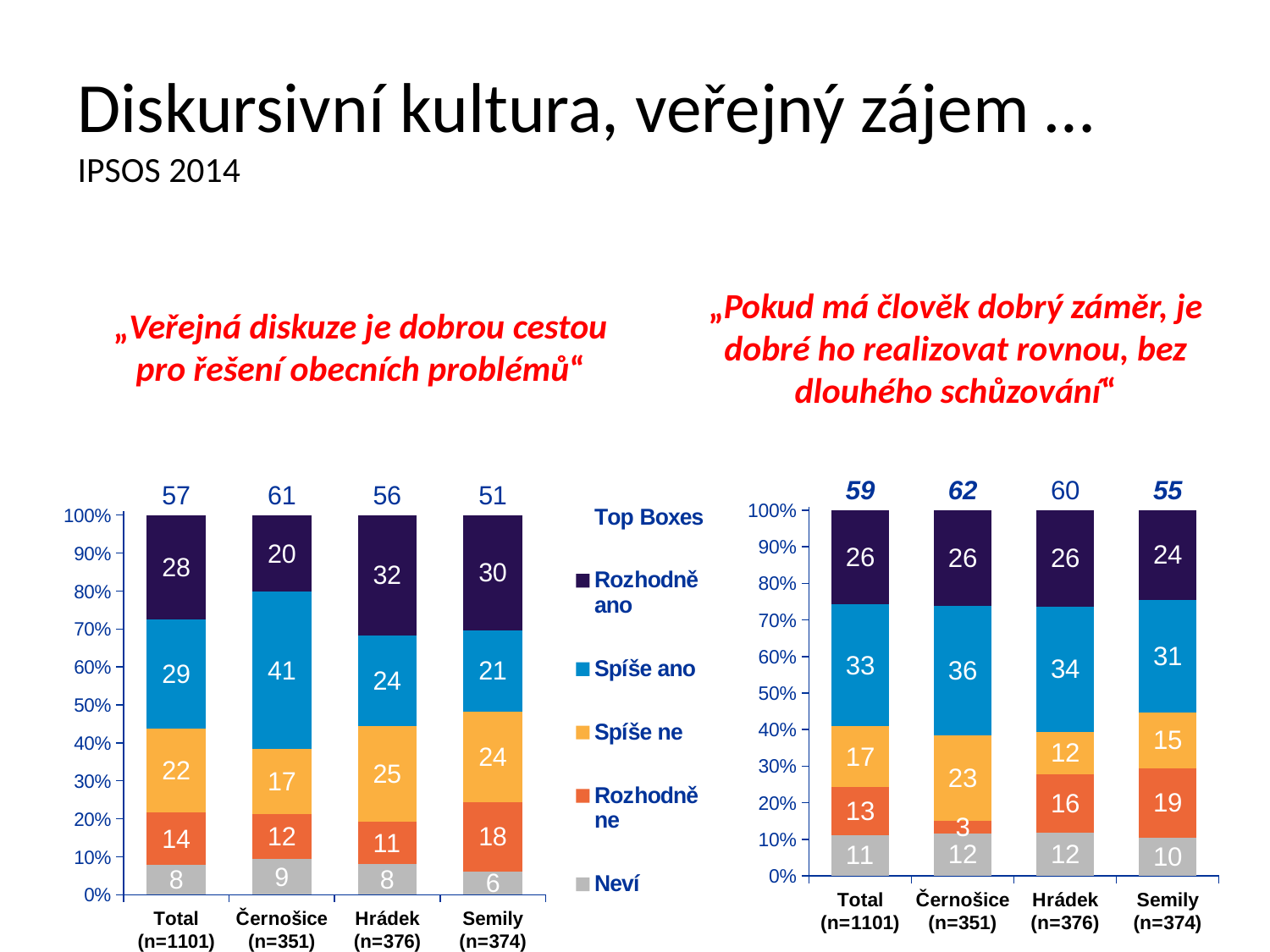
In the left chart, what is the "Neví" value for Semily (n=374)? 6 In the right chart, which is larger: the "Spíše ne" value for Černošice (n=351) or for Hrádek (n=376)? Černošice (n=351) Which legend entry is shown in the light blue colour? Spíše ano In the left chart ("Veřejná diskuze je dobrou cestou pro řešení obecních problémů"), what is the value of "Spíše ano" for Černošice (n=351)? 41 In the right chart, which category has the lowest Top Boxes value shown above the bars? Semily (n=374) How many series does the legend between the two charts list? 6 In the left chart, which category has the highest Top Boxes value shown above the bars? Černošice (n=351) In the right chart ("Pokud má člověk dobrý záměr..."), what is the value of "Rozhodně ne" for Černošice (n=351)? 3 In the left chart, what is the difference between the "Rozhodně ano" values for Hrádek (n=376) and Černošice (n=351)? 12 In the right chart, what is the Top Boxes value shown above the bar for Hrádek (n=376)? 60 What type of chart is the right chart? Stacked bar chart How many categories are shown on the x axis of the left chart? 4